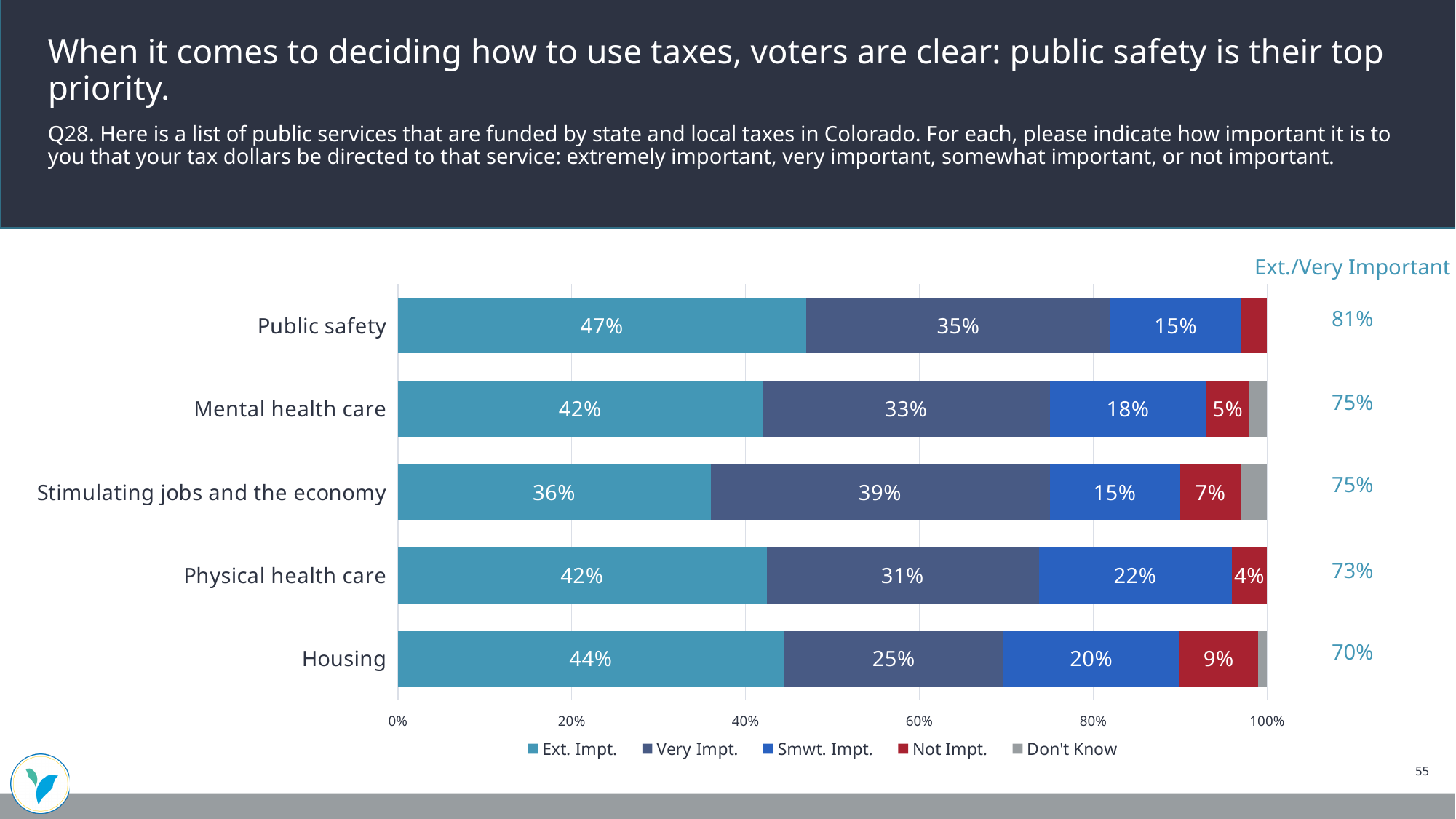
What is the Not Impt. value for Housing? 9% What percentage of voters rated public safety as extremely important (Ext. Impt.)? 47% Which category has the lowest Ext./Very Important combined figure? Housing Which category has the highest Ext. Impt. value? Public safety What is the difference between the Smwt. Impt. values for Physical health care and Public safety? 7% Which is larger: the Very Impt. value for Mental health care or for Physical health care? Mental health care What is the Ext./Very Important combined figure shown for Mental health care? 75% Which legend entry is shown in red? Not Impt. How many series does the legend list? 5 What is the Very Impt. value for Stimulating jobs and the economy? 39% What kind of chart is shown on the slide? Stacked bar chart How many categories are shown on the chart? 5